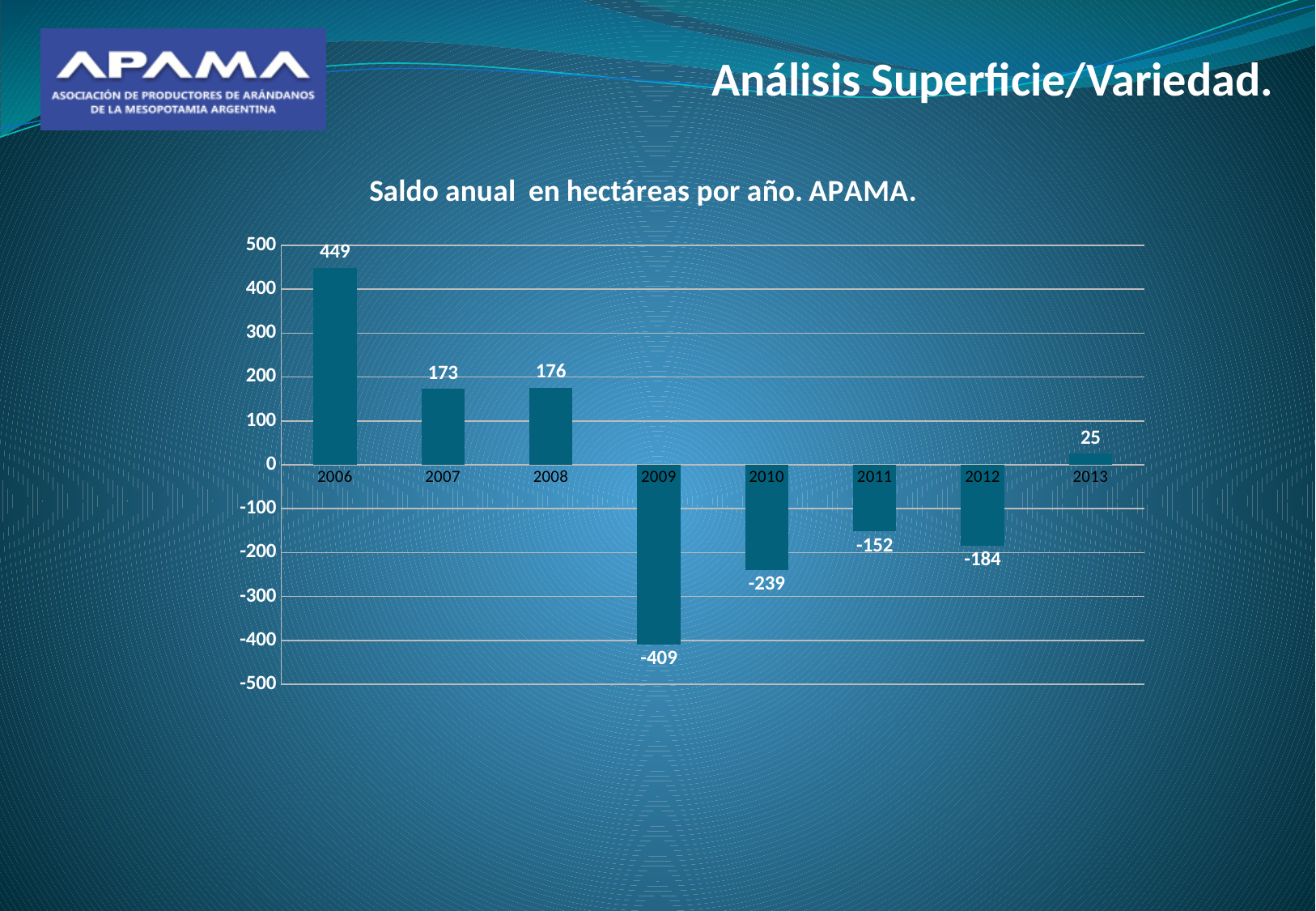
What is the value for 2006? 449 What is the value for 2009? -409 What is the difference between the values for 2010 and 2012? 55 What is the difference between the values for 2008 and 2007? 3 Which year has the lowest value? 2009 Which is larger, the value for 2011 or the value for 2012? 2011 Is the value for 2010 greater or less than -200? less What is the title of the chart? Saldo anual en hectáreas por año. APAMA. What kind of chart is shown on the slide? bar chart What is the value for 2013? 25 How many years are shown on the x axis? 8 Which year has the highest value? 2006